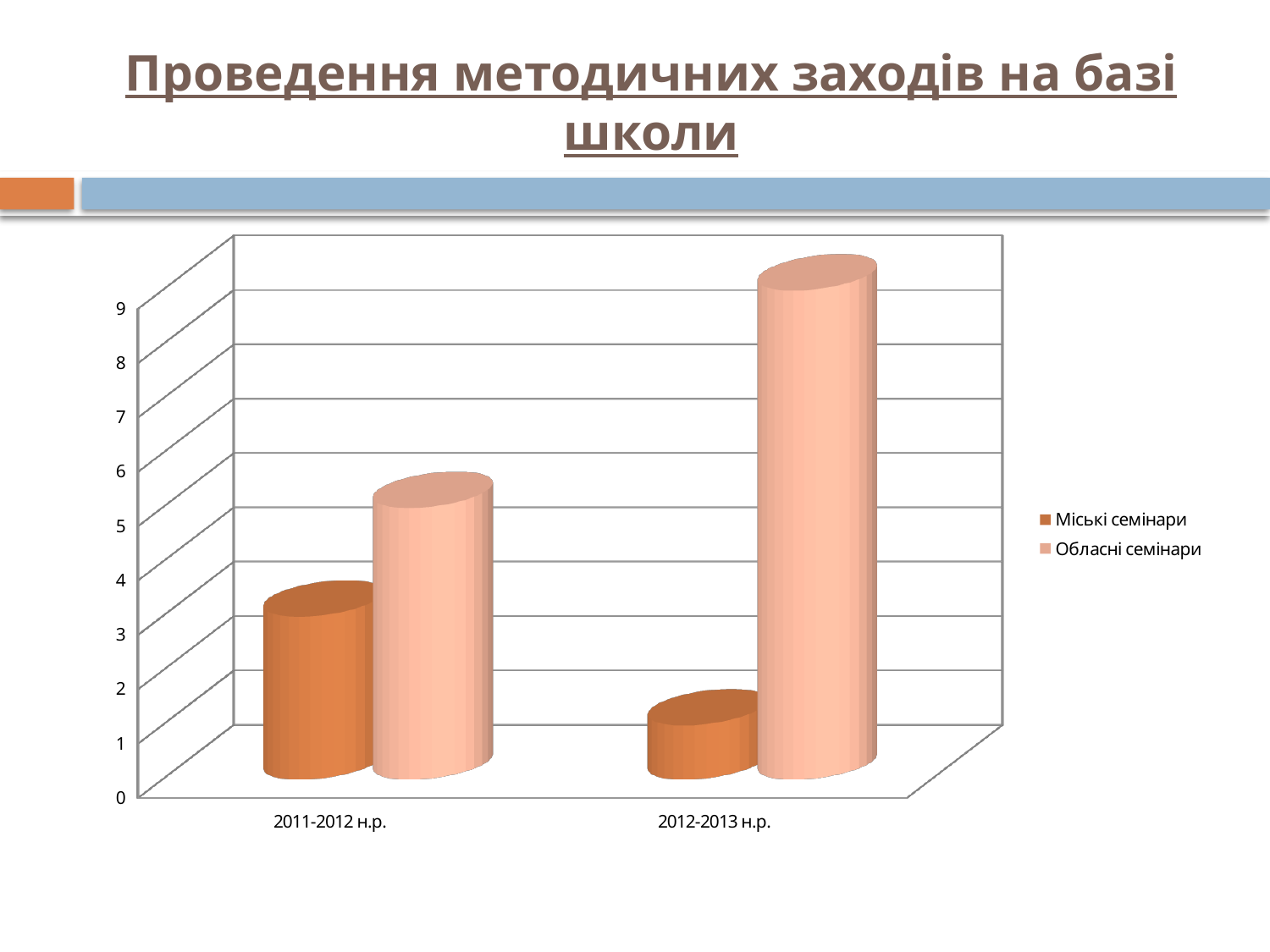
Is the value for Міські семінари in 2012-2013 н.р. greater or less than 2? less In 2011-2012 н.р., which is larger: Міські семінари or Обласні семінари? Обласні семінари Is the value for Міські семінари in 2011-2012 н.р. greater or less than 2? greater What kind of chart is shown on the slide? bar chart Which series and category has the tallest bar? Обласні семінари, 2012-2013 н.р. Does the value for Міські семінари rise or fall from 2011-2012 н.р. to 2012-2013 н.р.? fall How many series does the legend list? 2 How many categories are shown on the x axis? 2 In 2012-2013 н.р., which is larger: Міські семінари or Обласні семінари? Обласні семінари Does the value for Обласні семінари rise or fall from 2011-2012 н.р. to 2012-2013 н.р.? rise Which series and category has the shortest bar? Міські семінари, 2012-2013 н.р. Is the value for Обласні семінари in 2012-2013 н.р. greater or less than 7? greater